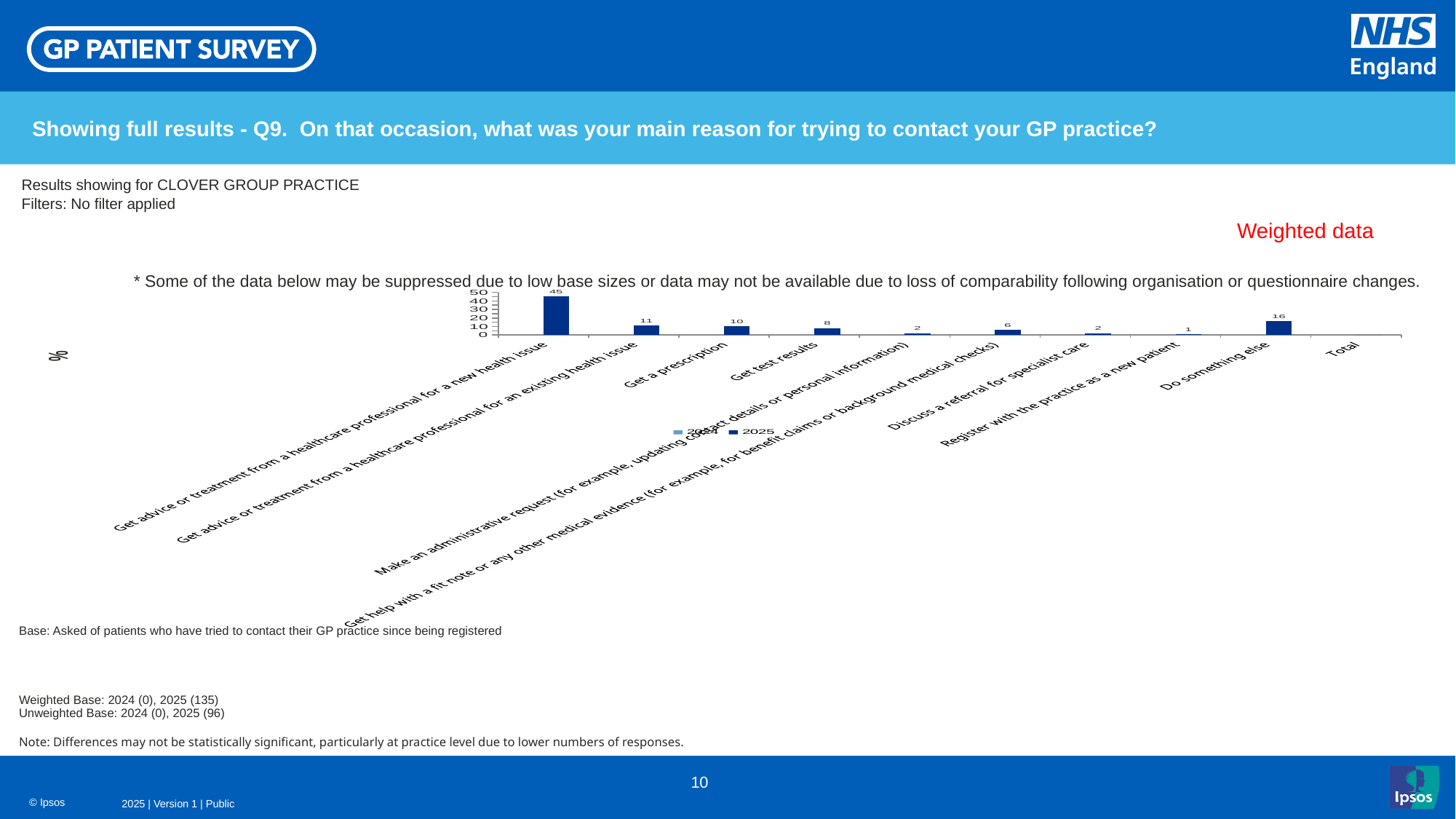
What is the difference between the 2025 values for 'Get advice or treatment from a healthcare professional for a new health issue' and 'Do something else'? 29 What kind of chart is shown on the slide? Bar chart What is the 2025 value for 'Get advice or treatment from a healthcare professional for a new health issue'? 45 What is the label on the vertical axis of the chart? % What is the 2025 value for 'Register with the practice as a new patient'? 1 Which category has the lowest 2025 value? Register with the practice as a new patient How many series does the legend list? 2 Which has the larger 2025 value: 'Get a prescription' or 'Get test results'? Get a prescription What is the 2025 value for 'Get test results'? 8 Which category has the highest 2025 value? Get advice or treatment from a healthcare professional for a new health issue What is the 2025 value for 'Do something else'? 16 What is the 2025 value for 'Get a prescription'? 10